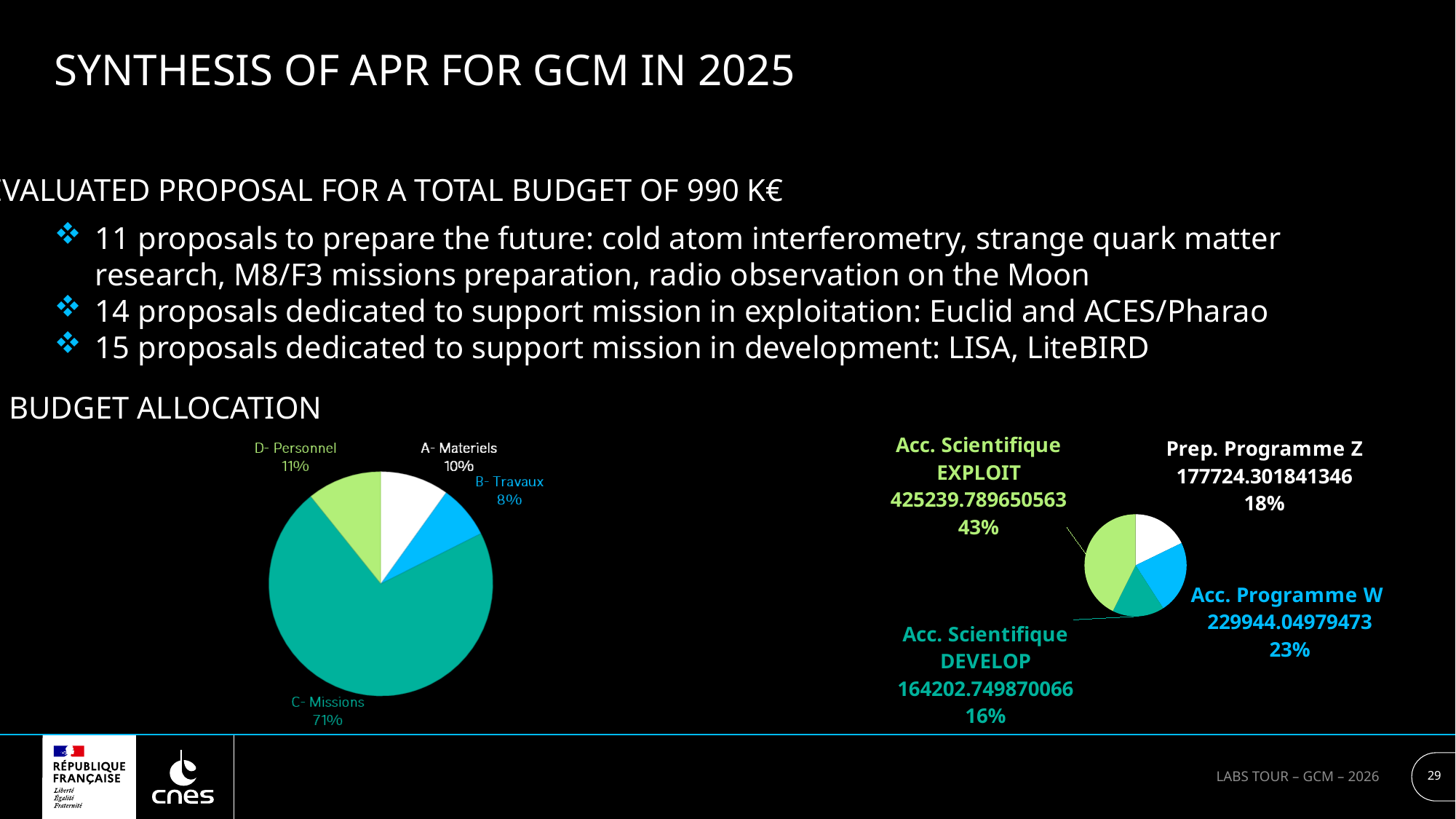
In the left pie chart, what share does B- Travaux have? 8% In the left pie chart, what share does C- Missions have? 71% How many slices does the right pie chart have? 4 In the right pie chart, what share does Acc. Scientifique DEVELOP have? 16% In the left pie chart, which category has the smallest slice? B- Travaux In the left pie chart, which category has the largest slice? C- Missions In the right pie chart, which category has the largest slice? Acc. Scientifique EXPLOIT In the right pie chart, which is larger: Prep. Programme Z or Acc. Programme W? Acc. Programme W In the right pie chart, what is the value for Acc. Programme W? 229944.04979473 What kind of chart is the left chart under BUDGET ALLOCATION? pie chart How many slices does the left pie chart have? 4 In the left pie chart, what is the difference in percentage points between D- Personnel and A- Materiels? 1%